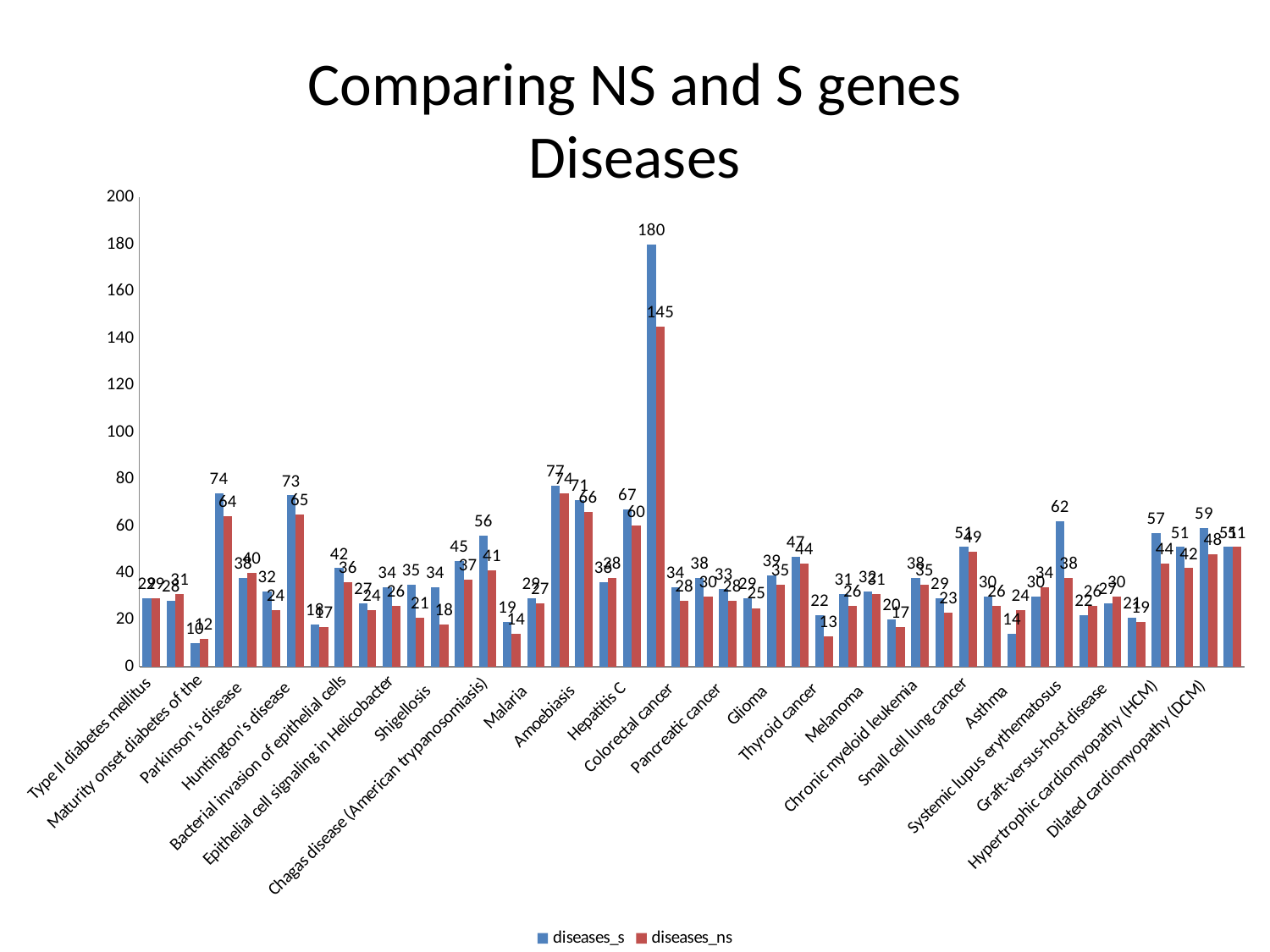
What is the diseases_s value for Type II diabetes mellitus? 29 What is the lowest value plotted for the diseases_s series? 10 What kind of chart is shown on the slide? bar chart Is the tallest diseases_s bar greater or less than 160? greater What is the highest value plotted for the diseases_s series? 180 What is the difference between the tallest diseases_s bar (180) and the diseases_ns bar beside it (145)? 35 What is the highest value plotted for the diseases_ns series? 145 What is the diseases_ns value for Type II diabetes mellitus? 29 How many series does the legend list? 2 What is the title of the chart? Comparing NS and S genes Diseases For Type II diabetes mellitus, which series has the larger value, diseases_s or diseases_ns? Neither; both are 29 What are the two series names shown in the legend? diseases_s and diseases_ns